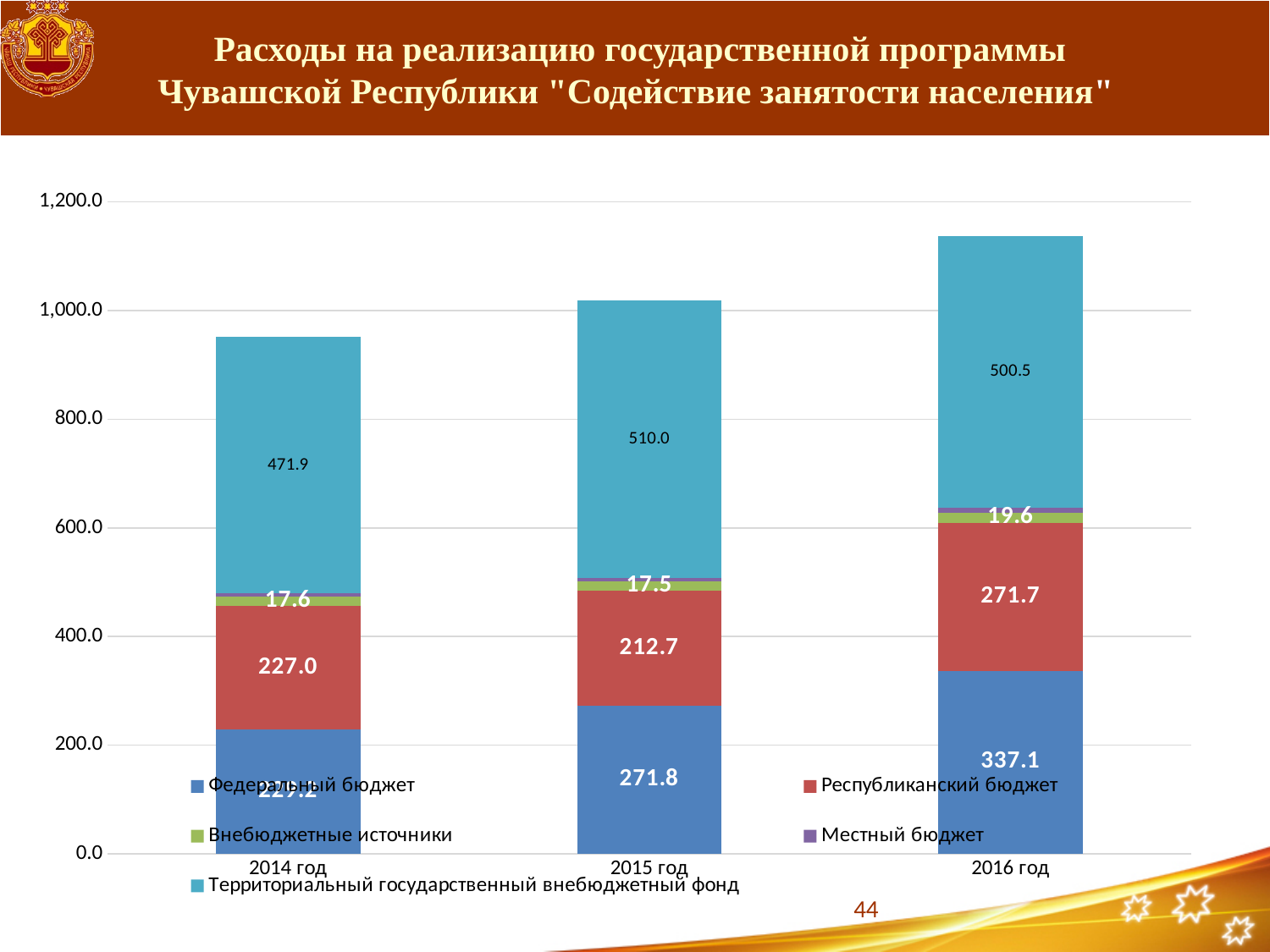
How many series does the legend list? 5 What is the value of Республиканский бюджет for 2016 год? 271.7 In which year is Федеральный бюджет the highest? 2016 год What is the value of Территориальный государственный внебюджетный фонд for 2015 год? 510.0 What is the difference between Республиканский бюджет in 2016 год and in 2015 год? 59.0 How many years are shown on the x axis? 3 What is the value of Внебюджетные источники for 2014 год? 17.6 Is the total height of the 2016 год bar greater or less than 1,000.0? greater In which year is Республиканский бюджет the lowest? 2015 год What is the value of Федеральный бюджет for 2015 год? 271.8 Which year has the larger value for Территориальный государственный внебюджетный фонд, 2015 год or 2016 год? 2015 год What kind of chart is shown on the slide? Stacked bar chart